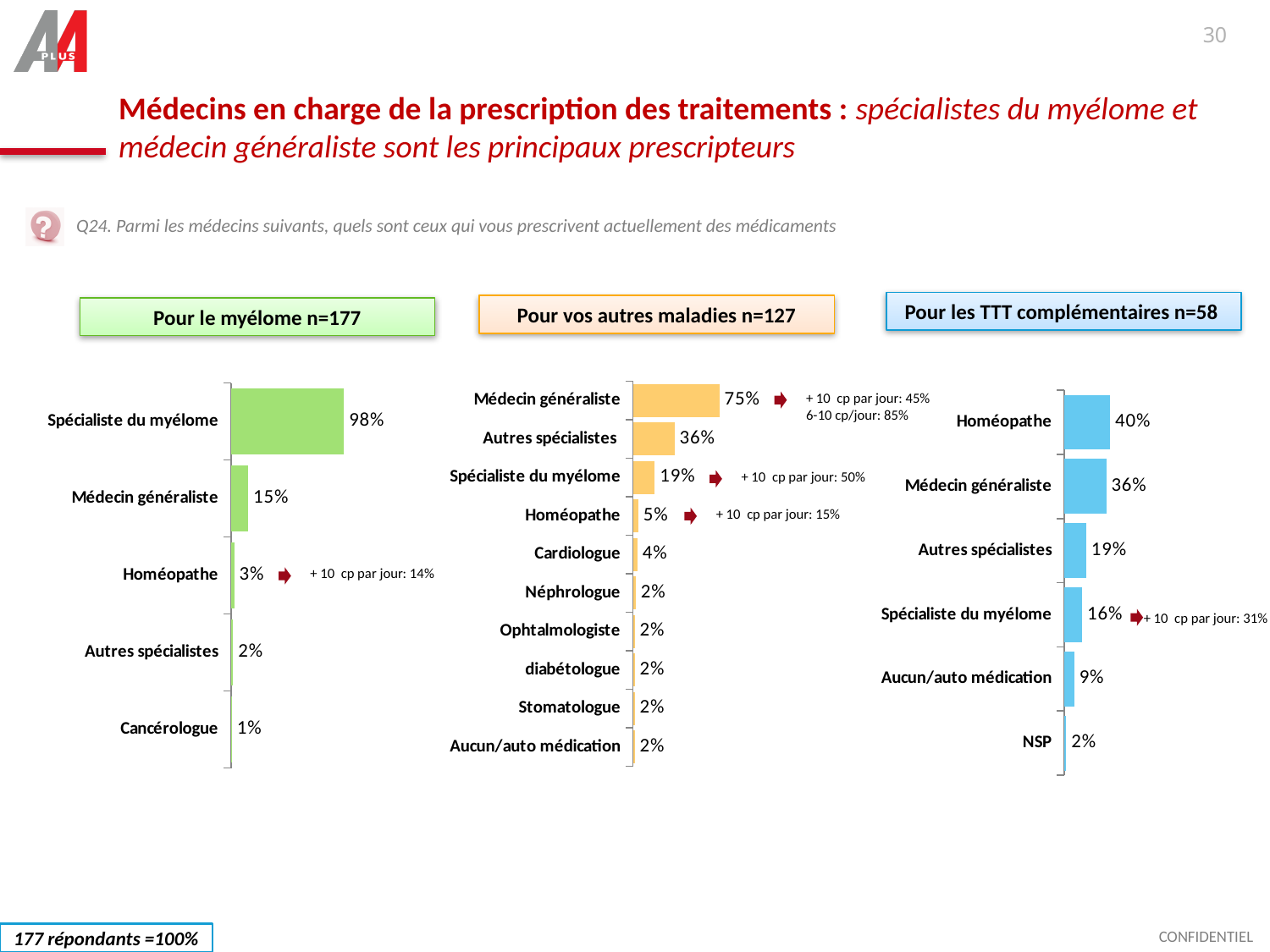
In the 'Pour les TTT complémentaires n=58' chart, which category has the highest value? Homéopathe In the 'Pour vos autres maladies n=127' chart, which is larger: Autres spécialistes or Spécialiste du myélome? Autres spécialistes In the 'Pour les TTT complémentaires n=58' chart, what is the value for Aucun/auto médication? 9% In the 'Pour le myélome n=177' chart, what is the difference between Spécialiste du myélome and Médecin généraliste? 83 percentage points What type of chart is the 'Pour les TTT complémentaires n=58' chart? Bar chart In the 'Pour vos autres maladies n=127' chart, what is the value for Cardiologue? 4% How many categories are shown in the 'Pour vos autres maladies n=127' chart? 10 In the 'Pour le myélome n=177' chart, which category has the lowest value? Cancérologue How many categories are shown in the 'Pour le myélome n=177' chart? 5 In the 'Pour le myélome n=177' chart, what is the value for Spécialiste du myélome? 98% In the 'Pour vos autres maladies n=127' chart, what is the value for Médecin généraliste? 75% In the 'Pour les TTT complémentaires n=58' chart, what is the difference between Homéopathe and Spécialiste du myélome? 24 percentage points